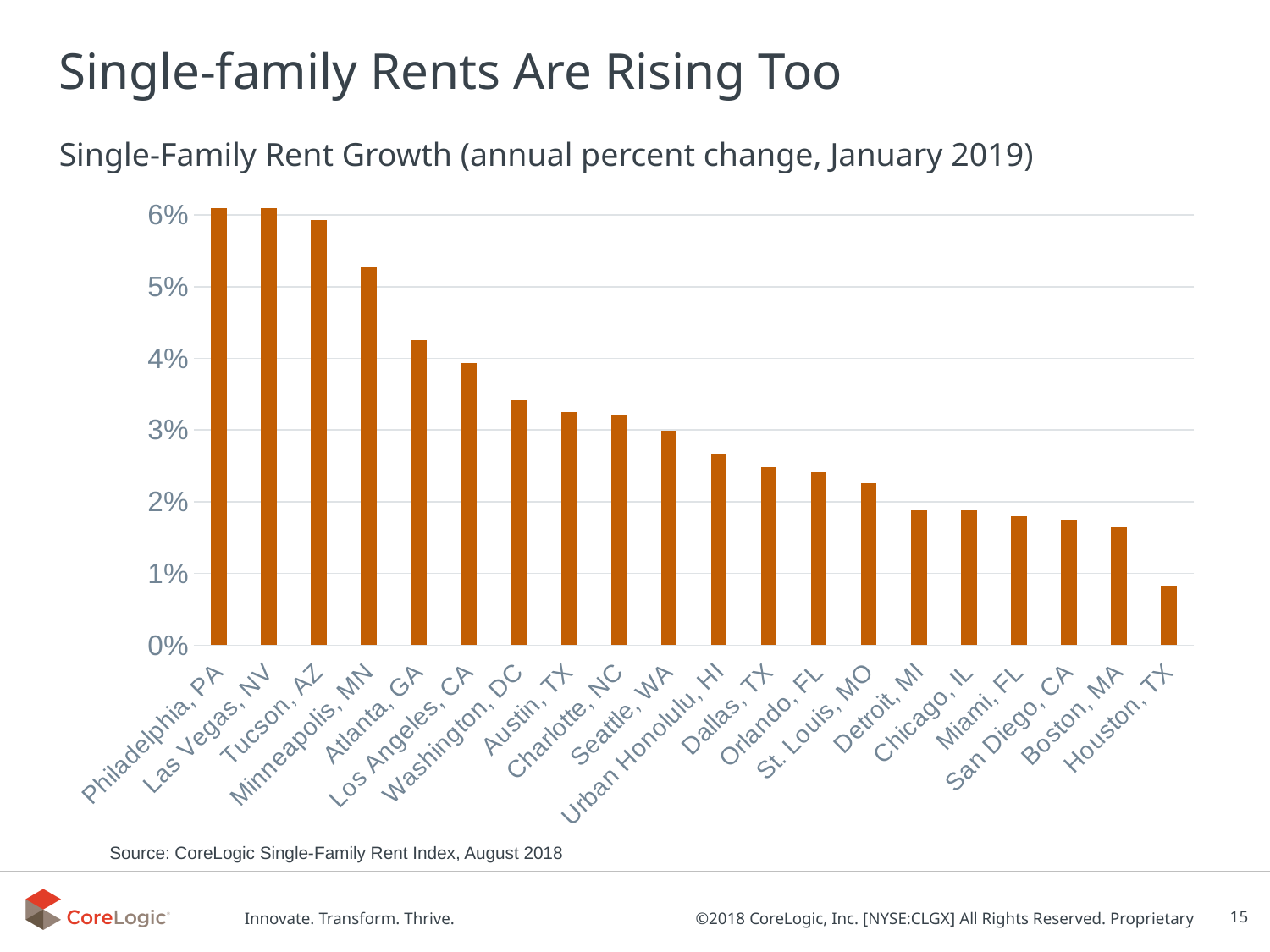
Do the values rise or fall moving from left to right across the chart? fall Is the value for Minneapolis, MN greater or less than 5%? greater Which has higher rent growth, Atlanta, GA or Los Angeles, CA? Atlanta, GA Is the value for Washington, DC greater or less than 3%? greater What is the title of the chart? Single-Family Rent Growth (annual percent change, January 2019) How many metro areas are shown on the chart? 20 What kind of chart is shown on the slide? bar chart Which metro area has the lowest single-family rent growth? Houston, TX Is the value for Houston, TX greater or less than 1%? less Which has higher rent growth, Tucson, AZ or Minneapolis, MN? Tucson, AZ